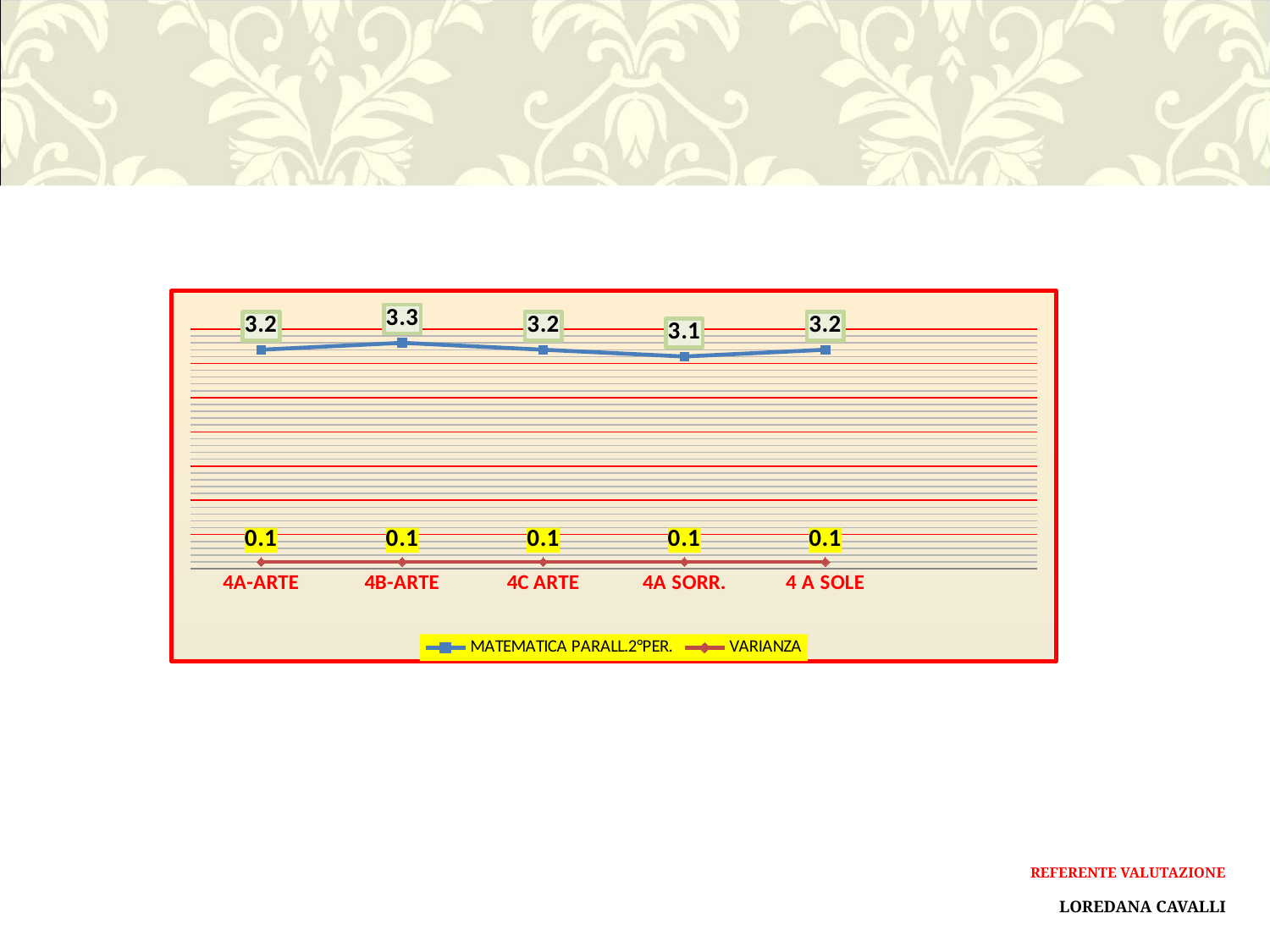
What is the value of MATEMATICA PARALL.2°PER. for 4B-ARTE? 3.3 Which is larger, the MATEMATICA PARALL.2°PER. value for 4A-ARTE or for 4A SORR.? 4A-ARTE What is the VARIANZA value for 4C ARTE? 0.1 What is the difference between the MATEMATICA PARALL.2°PER. values for 4B-ARTE and 4A SORR.? 0.2 How many series does the legend list? 2 Which category has the highest MATEMATICA PARALL.2°PER. value? 4B-ARTE What is the value of MATEMATICA PARALL.2°PER. for 4 A SOLE? 3.2 How many categories are shown on the x axis? 5 Which category has the lowest MATEMATICA PARALL.2°PER. value? 4A SORR. What kind of chart is shown on the slide? Line chart Which series is drawn in blue in the legend? MATEMATICA PARALL.2°PER. What is the value of MATEMATICA PARALL.2°PER. for 4A SORR.? 3.1